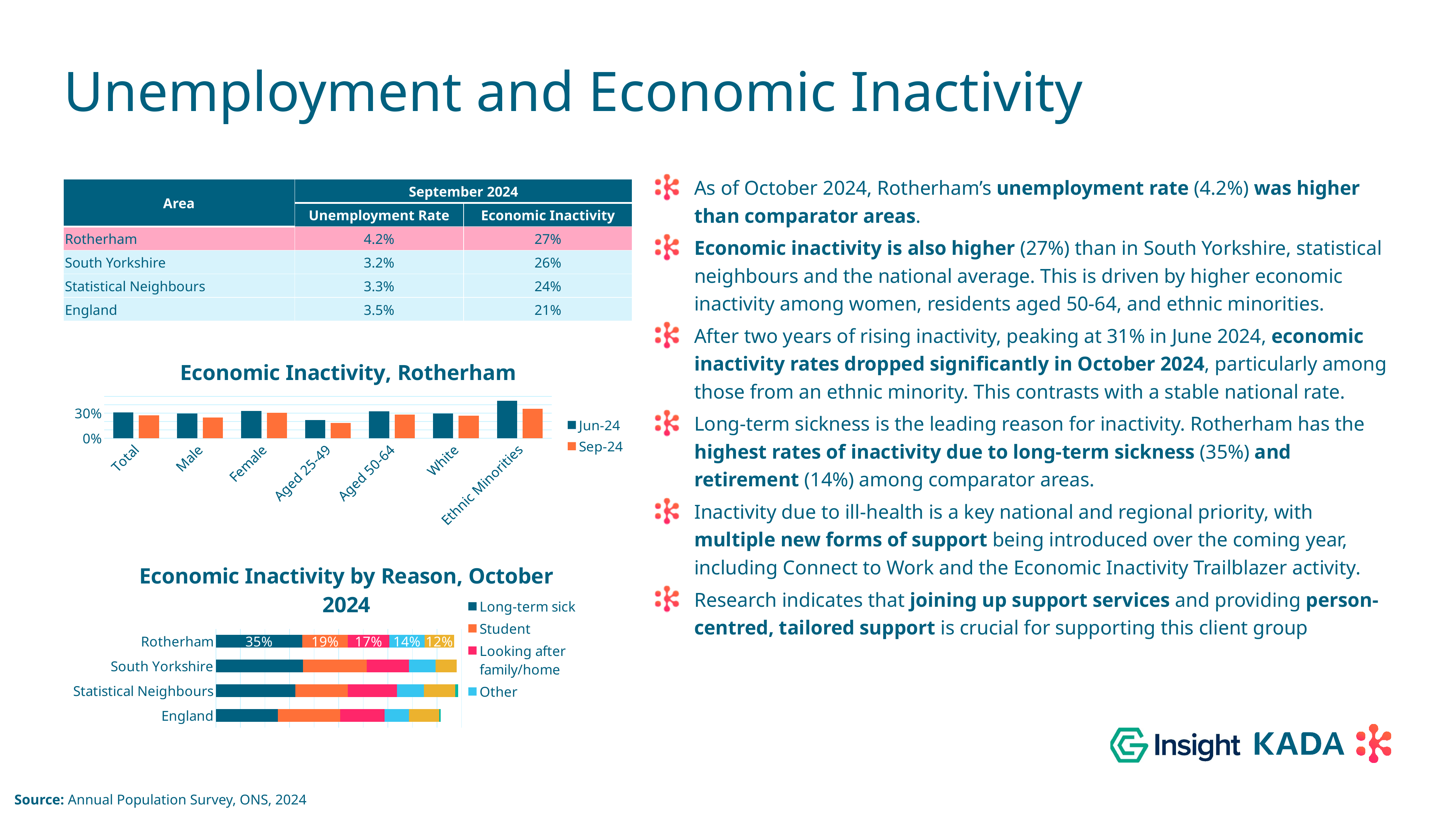
In the 'Economic Inactivity by Reason, October 2024' chart, what is the Long-term sick value for Rotherham? 35% In the 'Economic Inactivity, Rotherham' chart, how many categories are shown on the x axis? 7 In the 'Economic Inactivity, Rotherham' chart, is the Sep-24 value for Aged 25-49 greater or less than 30%? less In the 'Economic Inactivity, Rotherham' chart, for Ethnic Minorities, which is larger: the Jun-24 value or the Sep-24 value? Jun-24 In the 'Economic Inactivity, Rotherham' chart, which category has the highest Jun-24 value? Ethnic Minorities In the 'Economic Inactivity by Reason, October 2024' chart, how many areas are shown on the y axis? 4 In the 'Economic Inactivity, Rotherham' chart, how many series does the legend list? 2 In the 'Economic Inactivity, Rotherham' chart, which category has the lowest Jun-24 value? Aged 25-49 In the 'Economic Inactivity by Reason, October 2024' chart, what is the Student value for Rotherham? 19% In the 'Economic Inactivity by Reason, October 2024' chart, what is the difference between the Long-term sick and Student values for Rotherham? 16% In the 'Economic Inactivity, Rotherham' chart, is the Jun-24 value for Ethnic Minorities greater or less than 30%? greater What kind of chart is 'Economic Inactivity, Rotherham'? Bar chart